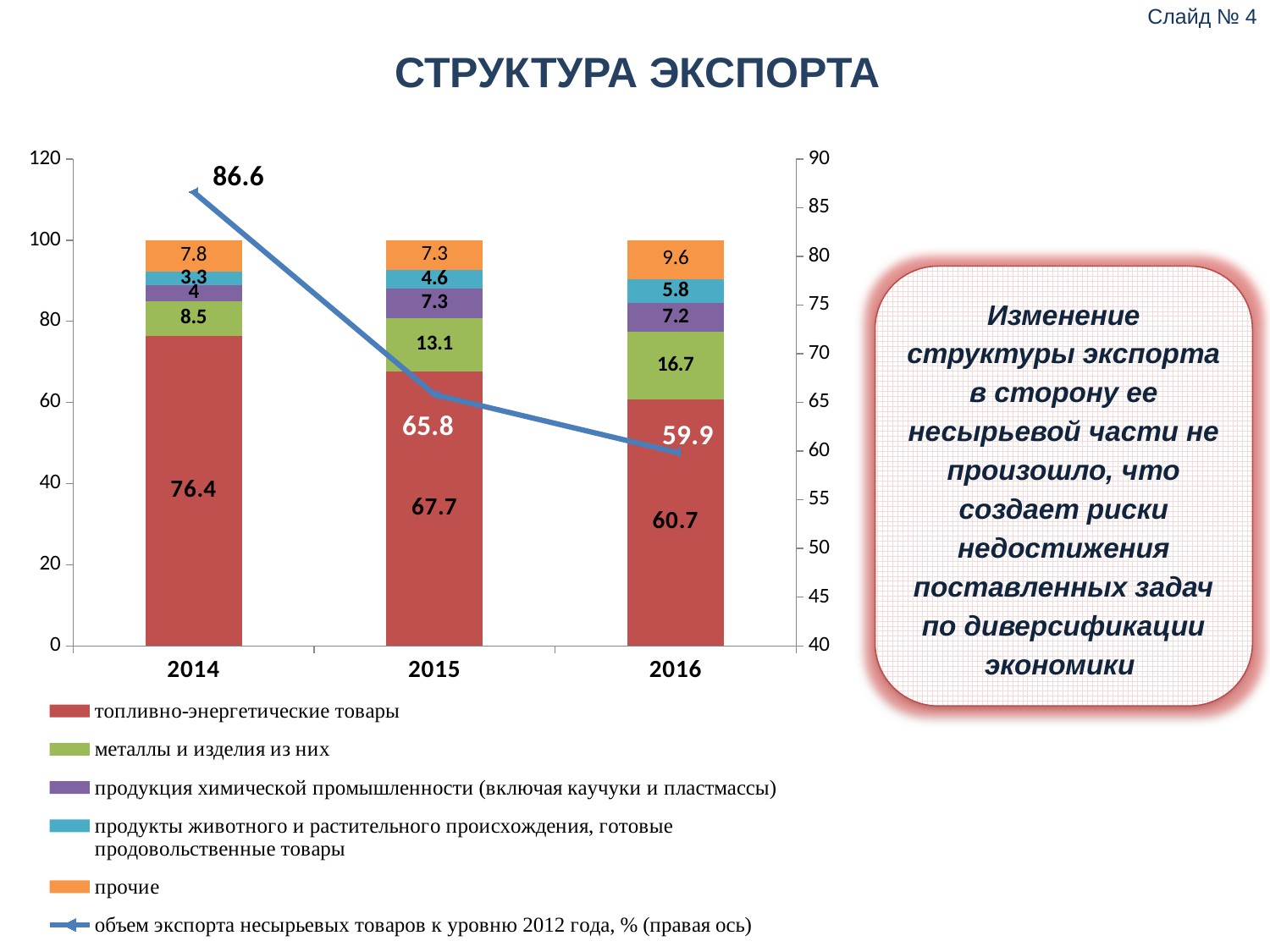
How does the line series (объем экспорта несырьевых товаров к уровню 2012 года) change from 2014 to 2016? It falls What is the title of the chart? СТРУКТУРА ЭКСПОРТА What is the value of the line series (объем экспорта несырьевых товаров к уровню 2012 года) in 2015? 65.8 What is the value for металлы и изделия из них in 2016? 16.7 In which year is the value for топливно-энергетические товары the highest? 2014 Which is larger: the value for продукция химической промышленности in 2015 or in 2016? 2015 What is the value for прочие in 2016? 9.6 In which year is the value for металлы и изделия из них the lowest? 2014 What is the difference between the топливно-энергетические товары values for 2014 and 2016? 15.7 What is the value for топливно-энергетические товары in 2014? 76.4 What is the total of the stacked bar for 2015? 100 How many series does the legend list? 6